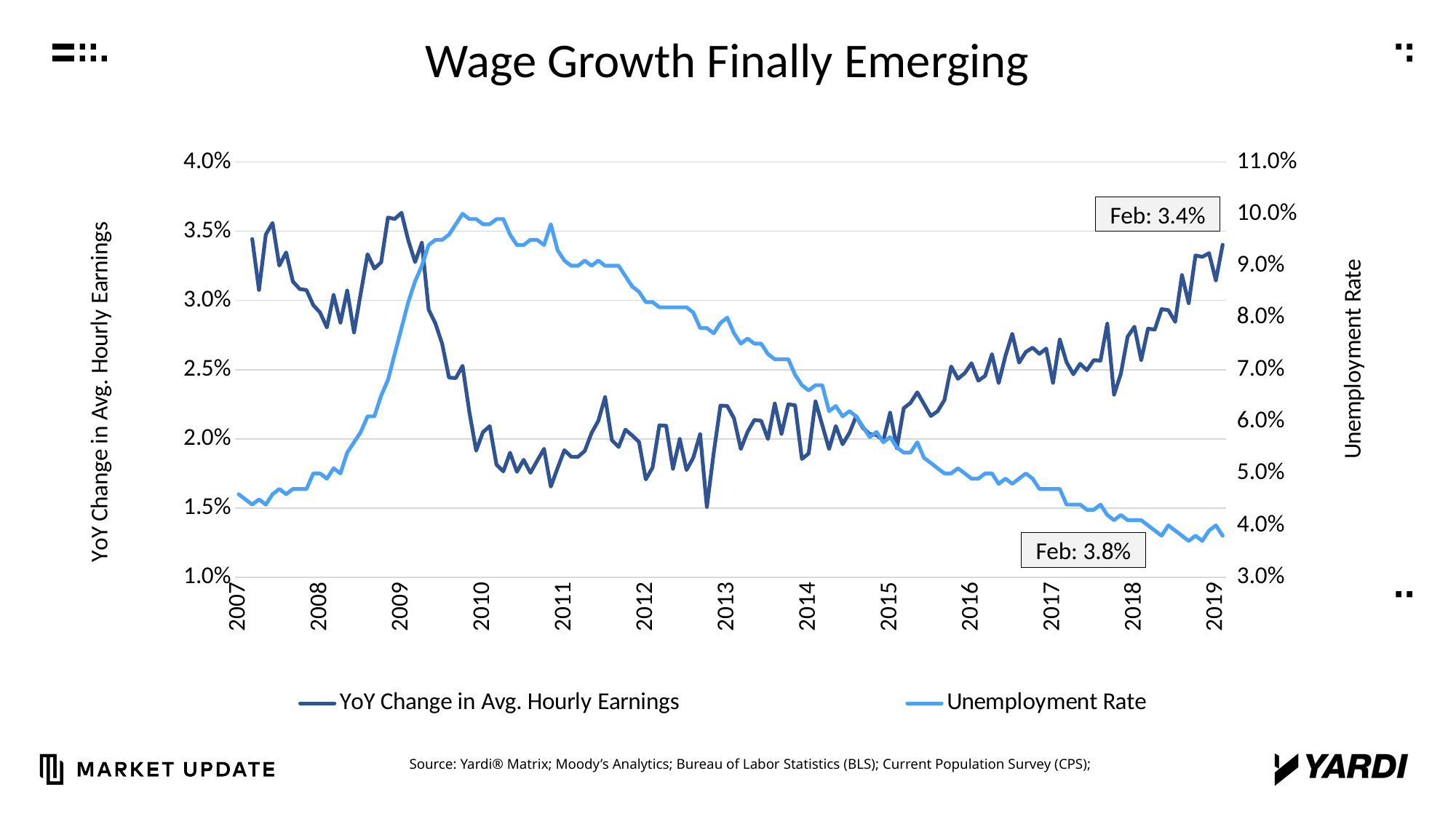
What is the labelled February value for YoY Change in Avg. Hourly Earnings? 3.4% What is the title of the chart? Wage Growth Finally Emerging Is the Unemployment Rate at the start of 2007 greater or less than 5.0%? less Which is higher, the Unemployment Rate in 2010 or in 2019? 2010 Does the YoY Change in Avg. Hourly Earnings rise or fall from 2015 to 2019? rise How many year labels are shown on the x axis? 13 How many series does the legend list? 2 What is the labelled February value for the Unemployment Rate? 3.8% Is the YoY Change in Avg. Hourly Earnings during 2012 greater or less than 2.5%? less Does the Unemployment Rate rise or fall from 2010 to 2019? fall What kind of chart is shown on the slide? line chart Is the peak Unemployment Rate around 2009-2010 greater or less than 9.0%? greater